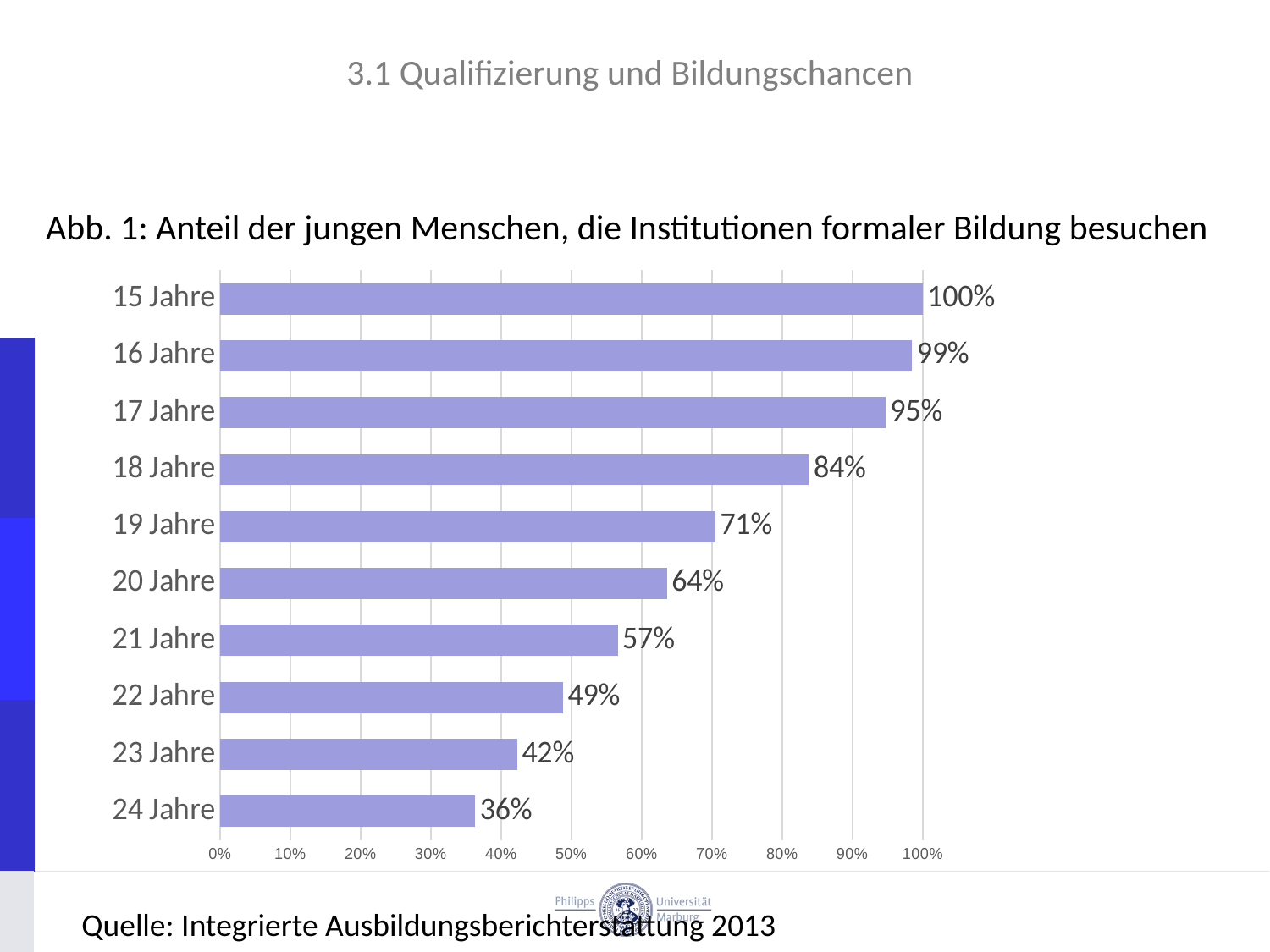
Which is larger, the value for 20 Jahre or the value for 22 Jahre? 20 Jahre Which age group has the highest value? 15 Jahre What is the title of the chart (Abb. 1)? Anteil der jungen Menschen, die Institutionen formaler Bildung besuchen Do the values rise or fall as age increases from 15 Jahre to 24 Jahre? fall How many age categories are shown in the chart? 10 Which age group has the lowest value? 24 Jahre What kind of chart is shown on the slide? bar chart What is the value for 18 Jahre? 84% What is the difference between the values for 17 Jahre and 19 Jahre? 24% What is the value for 24 Jahre? 36% Is the value for 23 Jahre greater or less than 50%? less What is the value for 21 Jahre? 57%